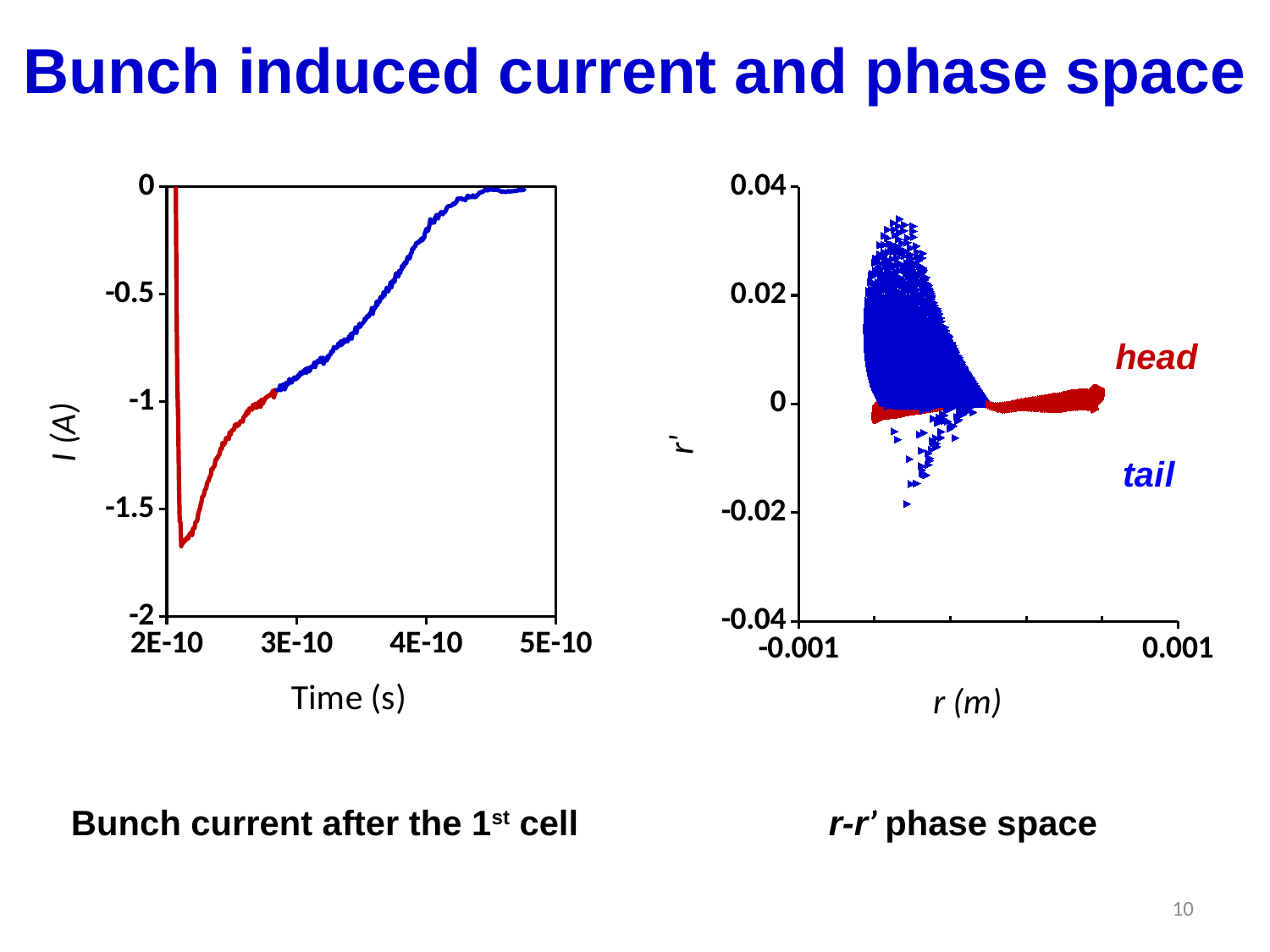
What is the label of the y axis of the left chart 'Bunch current after the 1st cell'? I (A) In the left chart 'Bunch current after the 1st cell', after reaching its minimum near 2E-10, does the current rise or fall as time increases? rises In the right chart 'r-r' phase space', which colour represents the tail? blue In the left chart 'Bunch current after the 1st cell', is the current at time 4E-10 greater or less than -1? greater What kind of chart is the left chart, 'Bunch current after the 1st cell'? line chart What kind of chart is the right chart, 'r-r' phase space'? scatter plot In the right chart 'r-r' phase space', is the highest r' value reached by the points greater or less than 0.02? greater In the left chart 'Bunch current after the 1st cell', is the lowest value of the current greater or less than -1.5? less